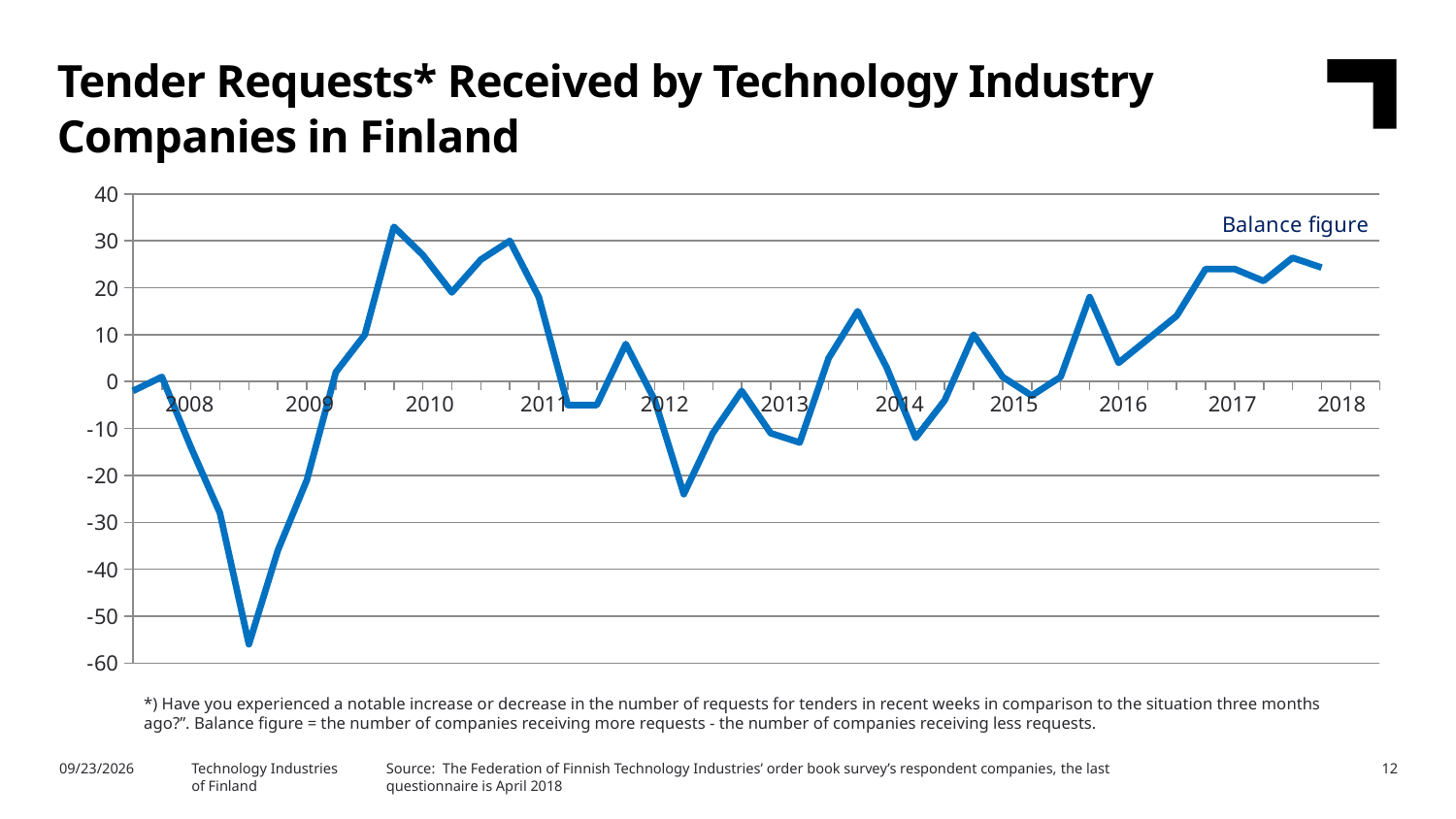
Is the balance figure at the last point of the line, near 2018, greater or less than 20? greater How many year labels are shown on the x axis? 11 Is the lowest value of the balance figure, reached around the start of 2009, greater or less than -50? less What kind of chart is shown on the slide? line chart Is the lowest balance figure in 2012 greater or less than -20? less Which is higher: the peak of the balance figure around 2010 or the peak around 2017? 2010 What is the title of the chart on the slide? Tender Requests* Received by Technology Industry Companies in Finland Does the balance figure rise or fall between its low point in early 2009 and its peak in 2010? rise